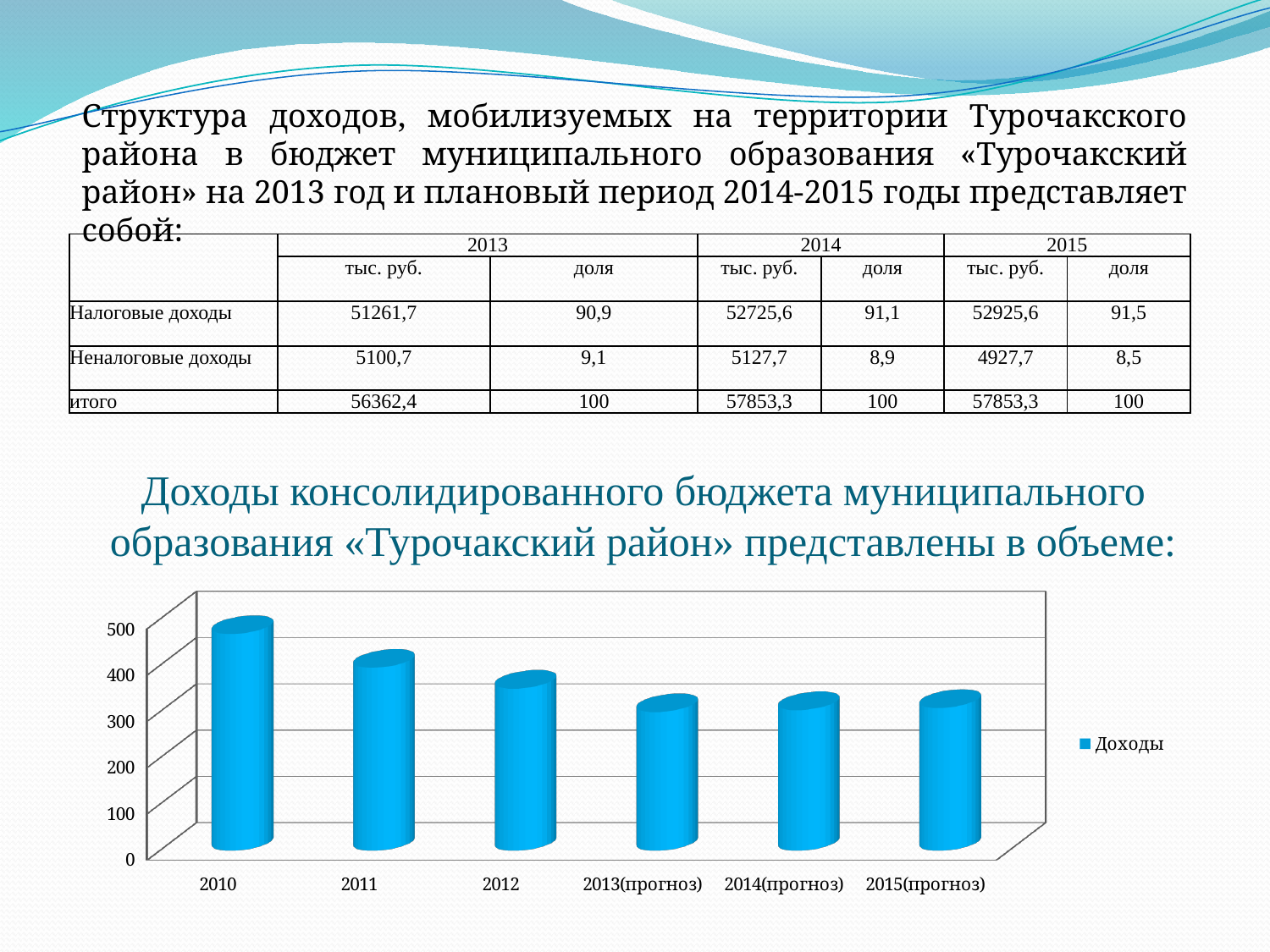
Do the values rise or fall from 2010 to 2012? fall What is the name of the series shown in the chart legend? Доходы Is the value for 2013(прогноз) greater or less than 400? less What kind of chart is shown on the slide? bar chart How many categories (years) are shown on the x axis of the chart? 6 Which year has the highest bar in the chart? 2010 Which is larger, the value for 2011 or the value for 2012? 2011 Is the value for 2015(прогноз) greater or less than 400? less How many series does the chart legend list? 1 Which is larger, the value for 2010 or the value for 2011? 2010 Is the value for 2012 greater or less than 300? greater